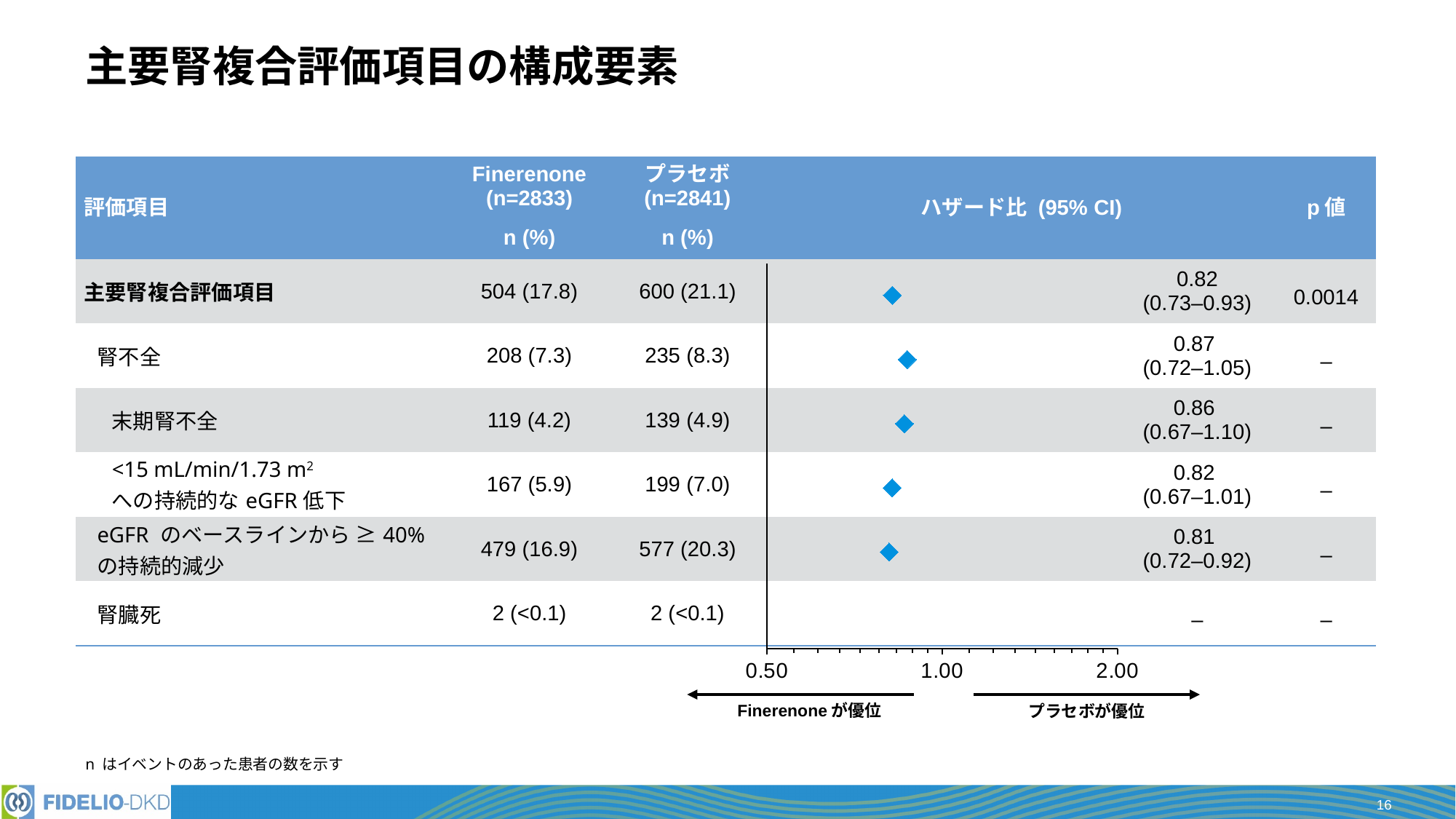
What is the 95% CI for the hazard ratio of 腎不全? 0.72–1.05 What does the label under the left-pointing arrow below the axis say? Finerenone が優位 Which has a larger hazard ratio, 腎不全 or eGFR のベースラインから ≥ 40% の持続的減少? 腎不全 Is the hazard ratio for 末期腎不全 greater or less than 1.00? less What is the p value shown for 主要腎複合評価項目? 0.0014 Which endpoint has the highest hazard ratio in the forest plot? 腎不全 What is the hazard ratio for 主要腎複合評価項目? 0.82 How many endpoints have a hazard ratio point plotted in the forest plot? 5 Which endpoint has the lowest hazard ratio in the forest plot? eGFR のベースラインから ≥ 40% の持続的減少 What is the difference between the hazard ratio for 腎不全 and the hazard ratio for eGFR のベースラインから ≥ 40% の持続的減少? 0.06 What kind of chart is shown on the slide? Forest plot What is the hazard ratio for eGFR のベースラインから ≥ 40% の持続的減少? 0.81